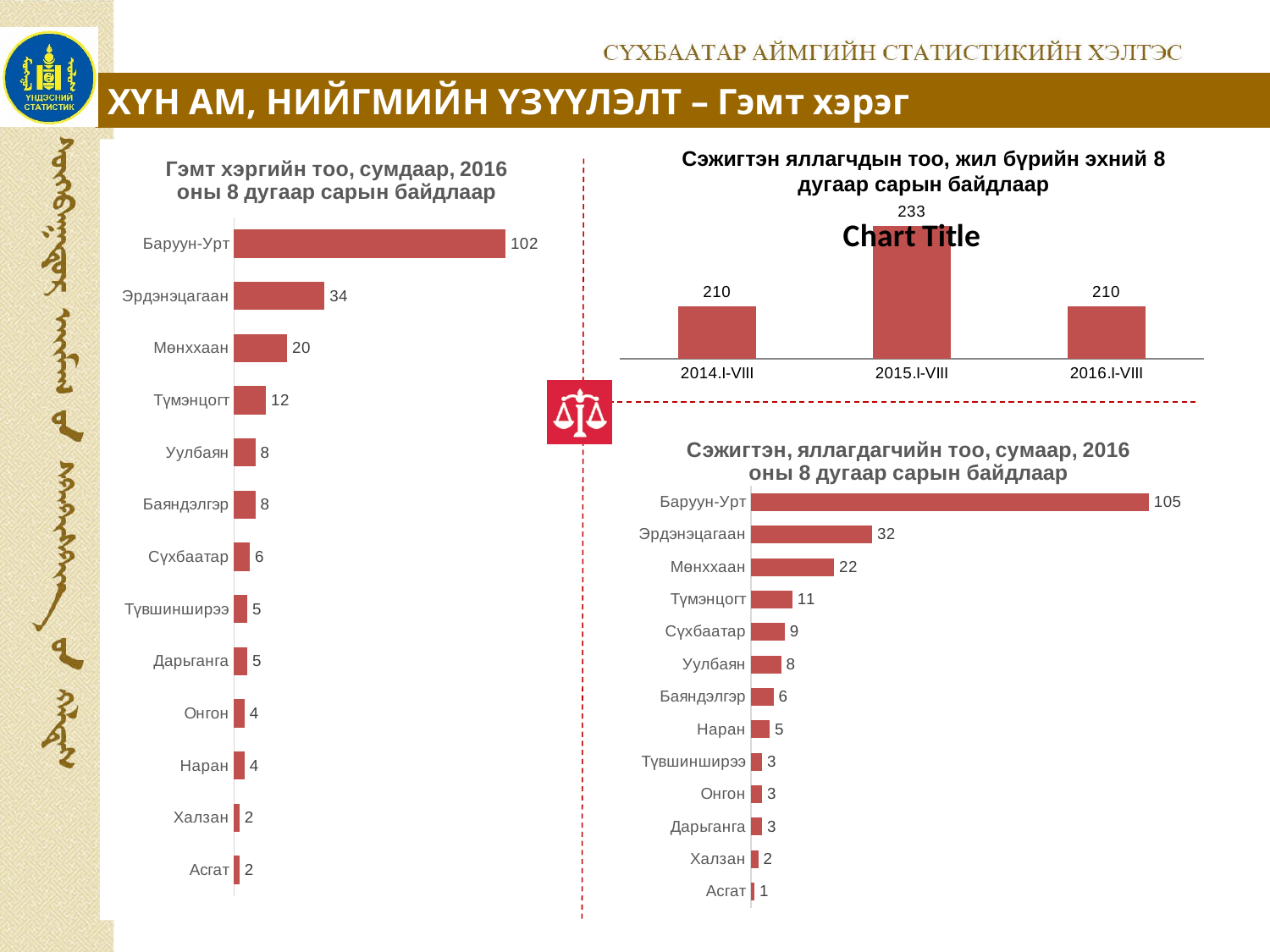
In the left chart 'Гэмт хэргийн тоо, сумдаар', which category has the highest value? Баруун-Урт What kind of chart is the top-right chart 'Сэжигтэн яллагчдын тоо'? Bar chart In the left chart 'Гэмт хэргийн тоо, сумдаар', how many categories are shown? 13 In the top-right chart 'Сэжигтэн яллагчдын тоо', which period has the highest value? 2015.I-VIII In the bottom-right chart 'Сэжигтэн, яллагдагчийн тоо, сумаар', which category has the lowest value? Асгат In the left chart 'Гэмт хэргийн тоо, сумдаар', what is the difference between the values for Баруун-Урт and Эрдэнэцагаан? 68 In the top-right chart 'Сэжигтэн яллагчдын тоо, жил бүрийн эхний 8 дугаар сарын байдлаар', what is the value for 2015.I-VIII? 233 In the bottom-right chart 'Сэжигтэн, яллагдагчийн тоо, сумаар', which is larger, the value for Сүхбаатар or the value for Уулбаян? Сүхбаатар In the left chart 'Гэмт хэргийн тоо, сумдаар', what is the value for Мөнххаан? 20 In the left chart 'Гэмт хэргийн тоо, сумдаар, 2016 оны 8 дугаар сарын байдлаар', what is the value for Баруун-Урт? 102 In the bottom-right chart 'Сэжигтэн, яллагдагчийн тоо, сумаар, 2016 оны 8 дугаар сарын байдлаар', what is the value for Баруун-Урт? 105 In the top-right chart 'Сэжигтэн яллагчдын тоо', what is the difference between the values for 2015.I-VIII and 2014.I-VIII? 23